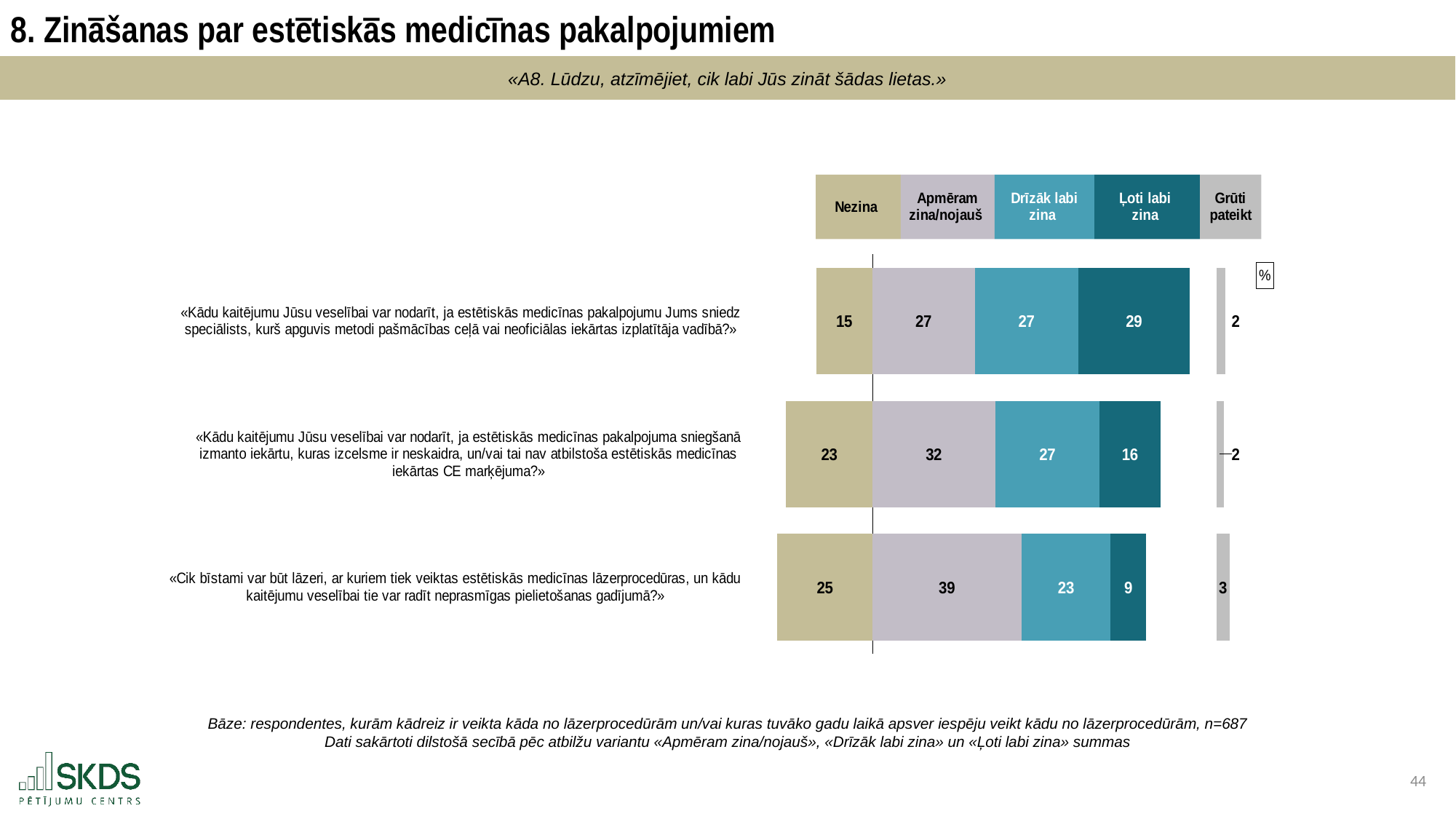
What is the value of "Nezina" for the middle bar (about equipment of unclear origin / CE marking)? 23 Which bar has the highest "Ļoti labi zina" value? The top bar (about a specialist who learned the method through self-study) What is the value of "Apmēram zina/nojauš" for the bottom bar (about the dangers of lasers)? 39 What kind of chart is shown on the slide? Stacked bar chart Which is larger for the middle bar: "Apmēram zina/nojauš" or "Drīzāk labi zina"? Apmēram zina/nojauš What is the difference between the "Apmēram zina/nojauš" values of the bottom bar and the top bar? 12 Which bar has the lowest "Nezina" value? The top bar (about a specialist who learned the method through self-study) How many series does the legend list? 5 What is the value of "Grūti pateikt" for the bottom bar (about the dangers of lasers)? 3 What is the value of "Ļoti labi zina" for the top bar (about a specialist who learned the method through self-study)? 29 What is the total of the "Nezina", "Apmēram zina/nojauš", "Drīzāk labi zina" and "Ļoti labi zina" segments of the bottom bar (about the dangers of lasers)? 96 How many bars (questions) are plotted in the chart? 3